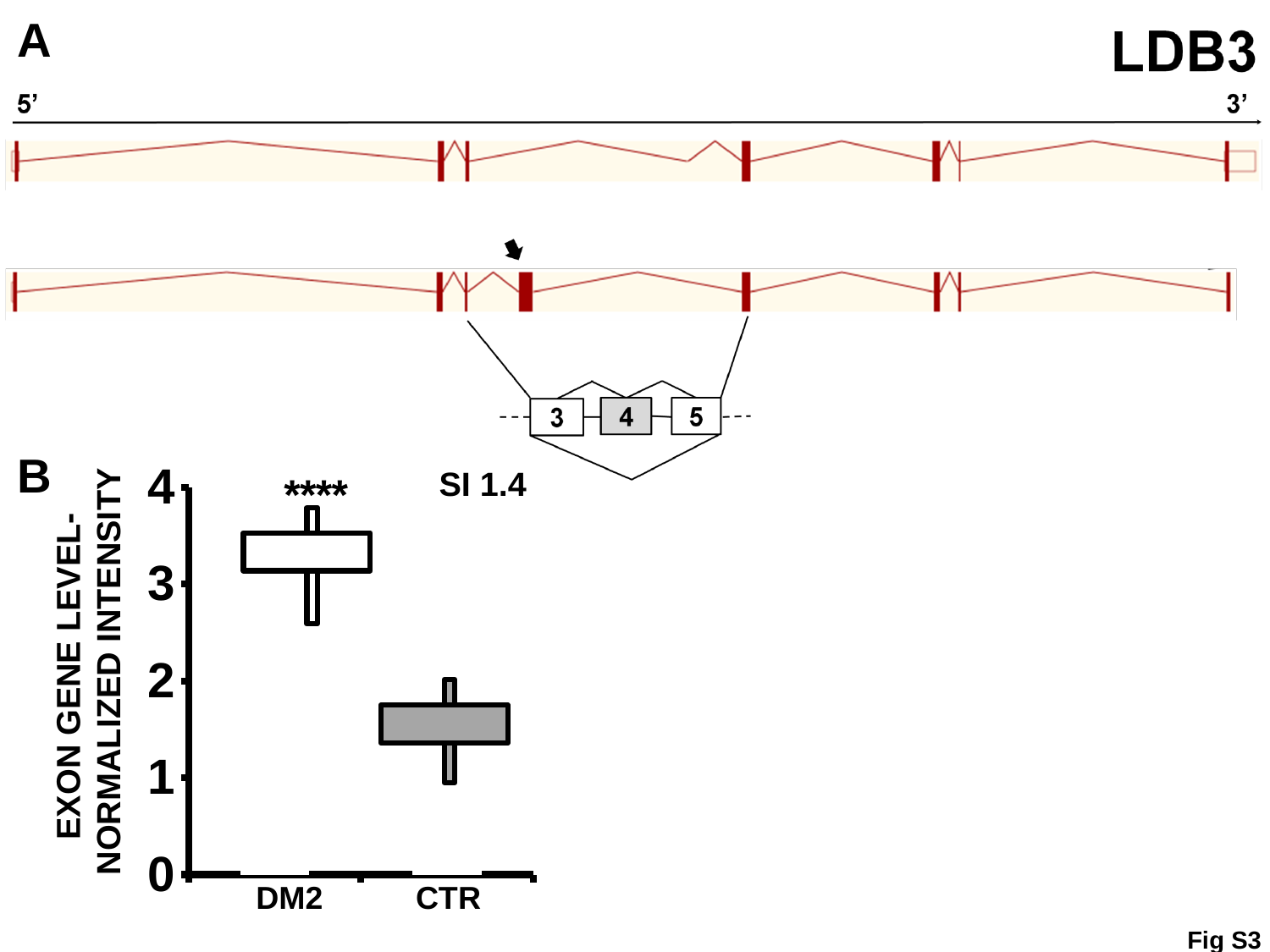
In the chart in panel B, is the median value for DM2 greater or less than 3? greater What kind of chart is shown in panel B? box plot What is the highest tick value shown on the y axis of the chart in panel B? 4 In the chart in panel B, which category has the higher exon gene level-normalized intensity, DM2 or CTR? DM2 In the chart in panel B, which category shows the lowest values? CTR What is the label of the y axis of the chart in panel B? EXON GENE LEVEL-NORMALIZED INTENSITY In the chart in panel B, which category shows the highest values? DM2 How many categories are shown on the x axis of the chart in panel B? 2 In the chart in panel B, is the median value for DM2 greater or less than 2? greater In the chart in panel B, is the median value for CTR greater or less than 3? less